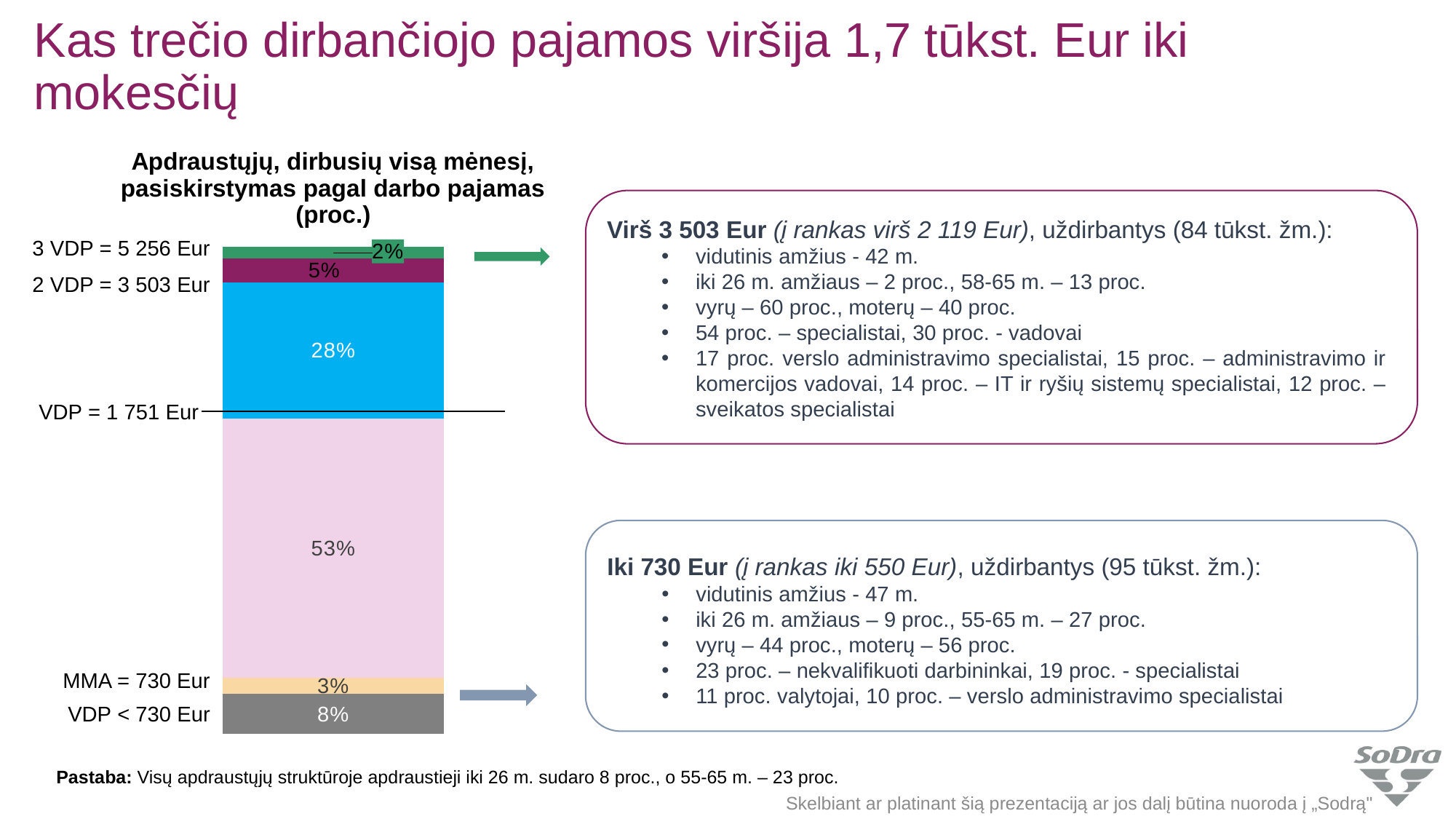
What is the combined share of the three segments above the 'VDP = 1 751 Eur' line (28%, 5% and 2%)? 35% What kind of chart is shown on the slide? Stacked bar chart What is the value of the orange segment at the 'MMA = 730 Eur' level? 3% What is the value of the grey bottom segment labelled 'VDP < 730 Eur'? 8% What is the title of the chart? Apdraustųjų, dirbusių visą mėnesį, pasiskirstymas pagal darbo pajamas (proc.) What is the value of the purple segment just below the '3 VDP = 5 256 Eur' line? 5% How many segments does the stacked bar contain? 6 What is the value of the smallest segment in the stacked bar? 2% What is the difference between the pink segment (53%) and the blue segment (28%)? 25 percentage points Which is larger, the purple segment or the green top segment? The purple segment (5%) What is the value of the largest segment in the stacked bar? 53% What is the value of the blue segment between the 'VDP = 1 751 Eur' and '2 VDP = 3 503 Eur' lines? 28%